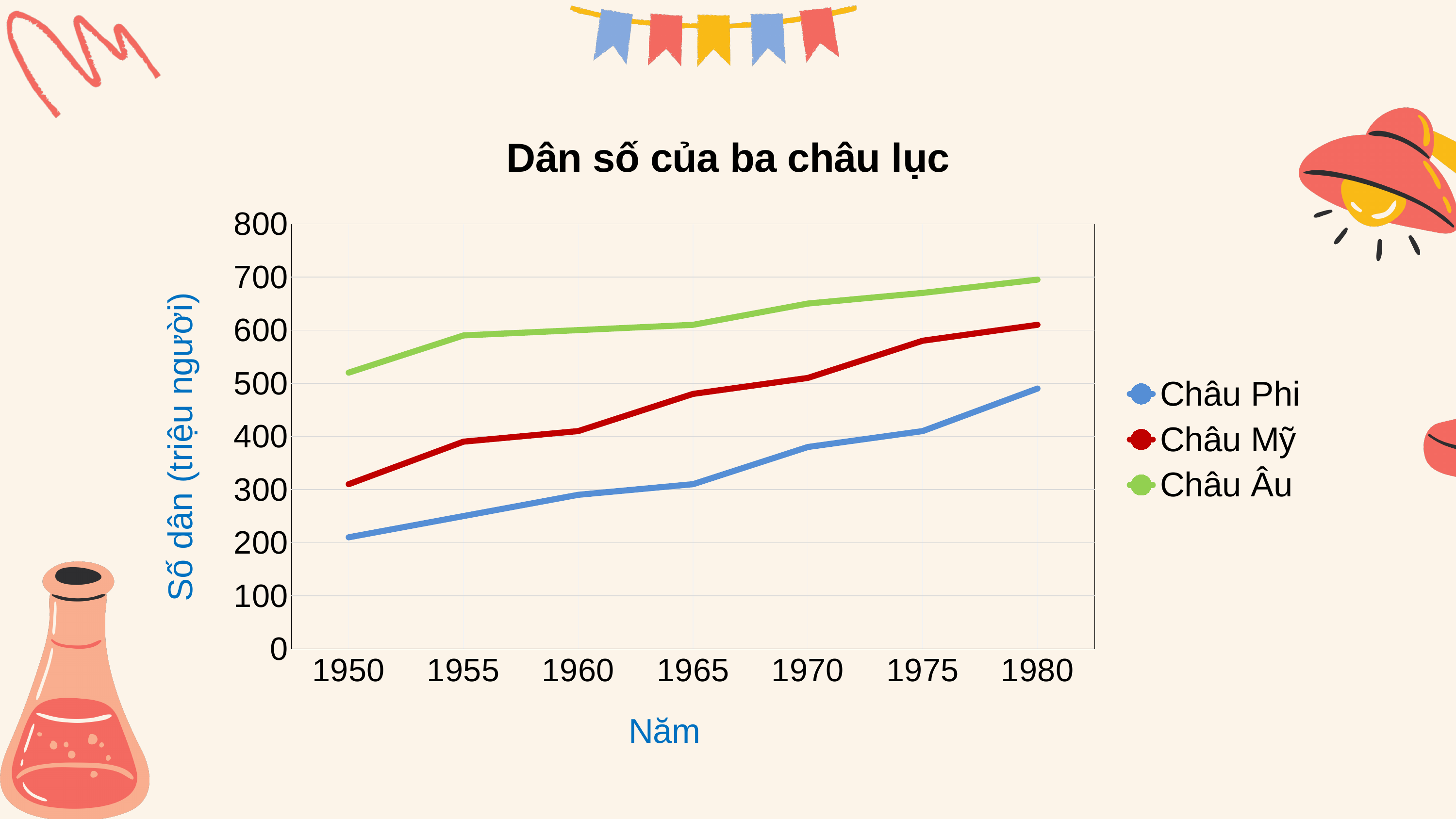
What is the title of the chart? Dân số của ba châu lục How many years are marked along the x axis? 7 Which series has the highest value in 1980? Châu Âu Is the value for Châu Phi in 1950 greater or less than 300? less What kind of chart is shown on the slide? line chart Is the value for Châu Mỹ in 1980 greater or less than 500? greater Which series has the lowest value in 1950? Châu Phi Is the value for Châu Âu in 1950 greater or less than 600? less Do the values for Châu Phi rise or fall from 1950 to 1980? rise Which is larger in 1970, the value for Châu Mỹ or the value for Châu Phi? Châu Mỹ How many series does the legend list? 3